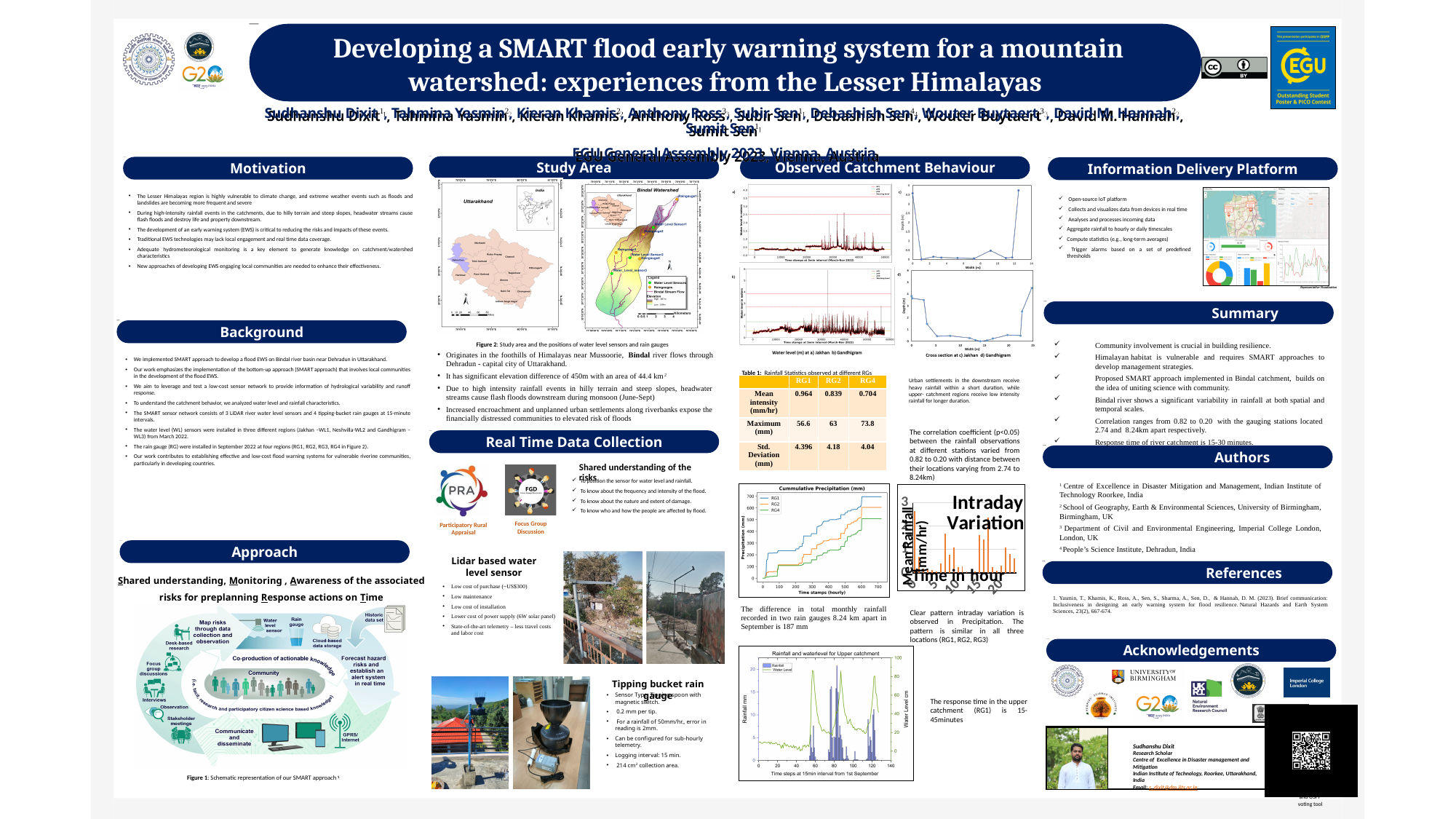
What kind of chart is the 'Intraday Variation' chart? bar chart In Table 1, which rain gauge has the highest Maximum (mm) value? RG4 What is the x-axis label of the 'Cummulative Precipitation (mm)' chart? Time stamps (hourly) In Table 1, what is the difference between the Maximum (mm) values of RG4 and RG1? 17.2 Which series are listed in the legend of the 'Cummulative Precipitation (mm)' chart? RG1, RG2, RG4 In the 'Cummulative Precipitation (mm)' chart, do the values rise or fall along the x axis? rise In the 'Cummulative Precipitation (mm)' chart, is the final value for RG4 greater or less than 600? less How many series does the legend of the 'Rainfall and waterlevel for Upper catchment' chart list? 2 What kind of chart is the 'Cummulative Precipitation (mm)' chart? line chart In the 'Rainfall and waterlevel for Upper catchment' chart, what is the maximum value shown on the right-hand Water Level axis? 100 How many series does the legend of the 'Cummulative Precipitation (mm)' chart list? 3 In Table 1, what is the Mean intensity (mm/hr) for RG1? 0.964